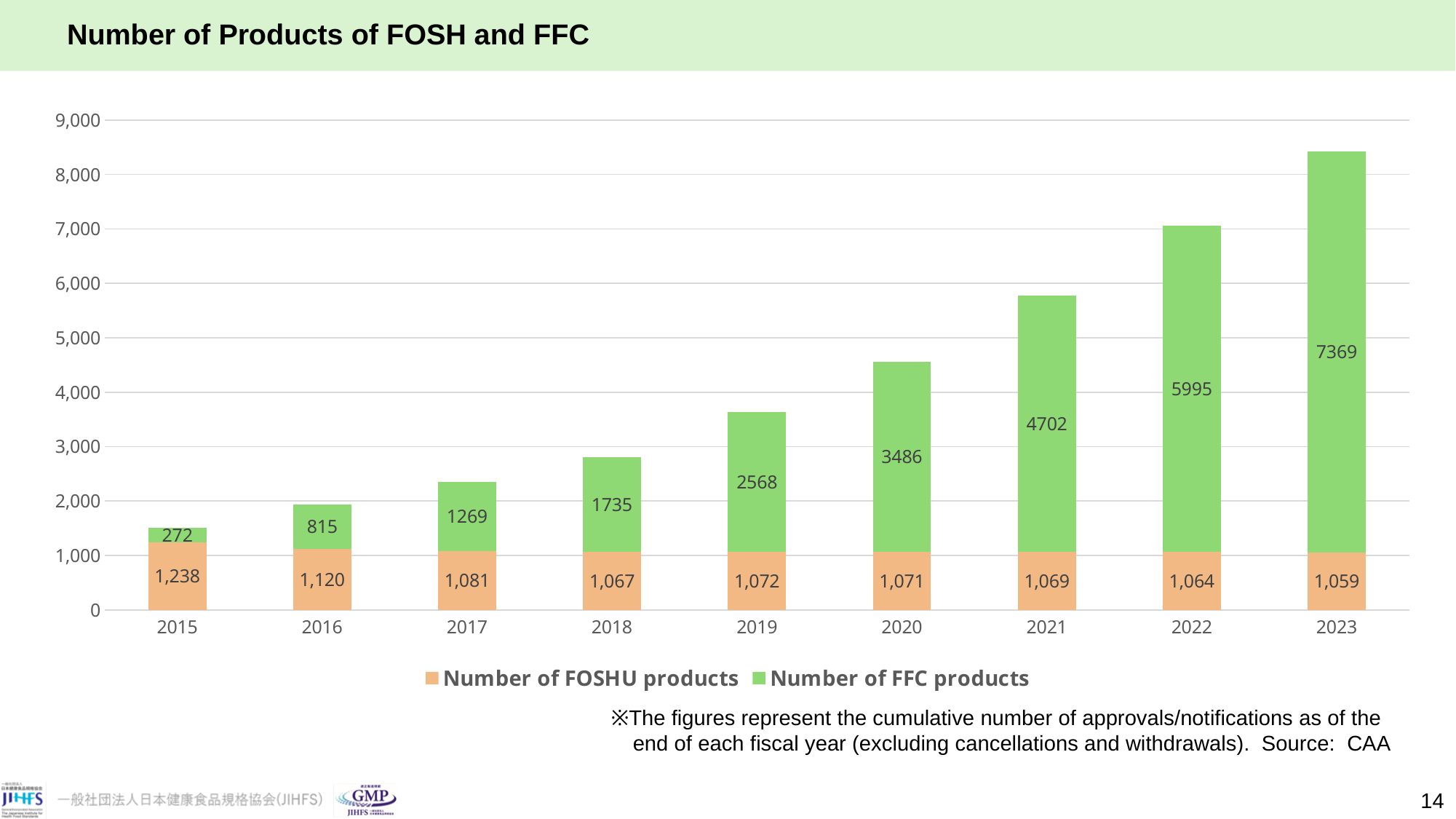
What is the total of the stacked bar for 2019? 3640 Which year has the highest number of FFC products? 2023 What kind of chart is shown on the slide? Stacked bar chart What is the number of FFC products in 2020? 3486 How many years are shown on the x axis? 9 What is the number of FOSHU products in 2015? 1,238 Which is larger, the number of FOSHU products in 2016 or the number of FFC products in 2016? Number of FOSHU products in 2016 What is the difference between the number of FFC products in 2023 and in 2022? 1374 How many series does the legend list? 2 What is the number of FFC products in 2023? 7369 Is the total height of the 2021 stacked bar greater or less than 5,000? greater Which year has the lowest number of FOSHU products? 2023